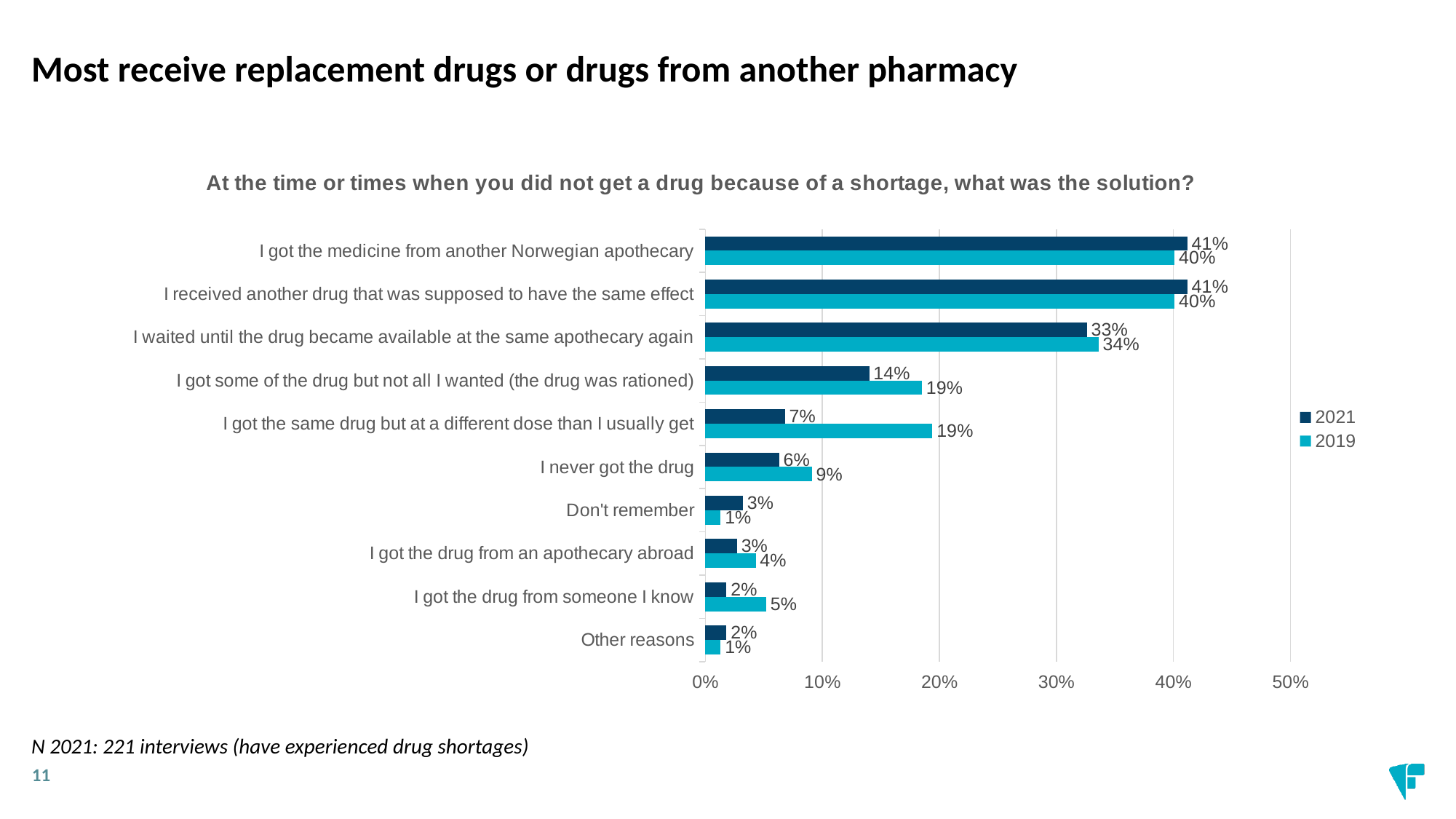
For "Don't remember", which year has the larger value, 2021 or 2019? 2021 What is the 2021 value for "I waited until the drug became available at the same apothecary again"? 33% What kind of chart is shown on the slide? Bar chart Which category has the lowest 2019 value? Don't remember and Other reasons (both 1%) What is the difference between the 2019 and 2021 values for "I got some of the drug but not all I wanted (the drug was rationed)"? 5 percentage points What is the 2019 value for "I got the drug from someone I know"? 5% What is the difference between the 2019 and 2021 values for "I got the same drug but at a different dose than I usually get"? 12 percentage points For "I never got the drug", which year has the larger value, 2021 or 2019? 2019 How many categories are shown on the chart? 10 How many series does the legend list? 2 What is the 2021 value for "I never got the drug"? 6% What is the 2019 value for "I got the same drug but at a different dose than I usually get"? 19%